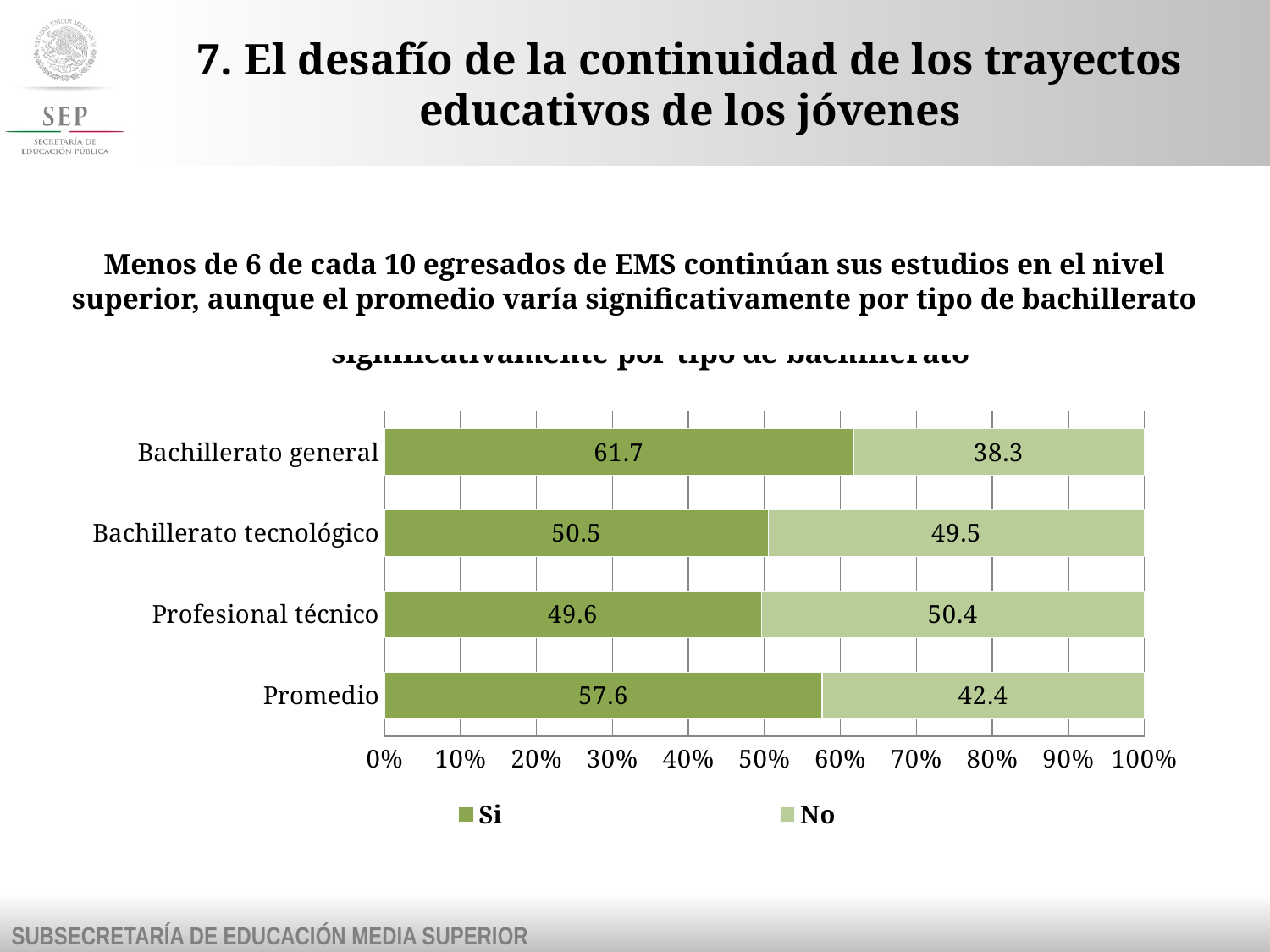
Which category has the highest "Si" value? Bachillerato general How many categories are shown on the chart? 4 Which category has the lowest "Si" value? Profesional técnico What is the "No" value for Profesional técnico? 50.4 What is the "No" value for Bachillerato tecnológico? 49.5 What is the "Si" value for Bachillerato general? 61.7 Which is larger: the "No" value for Bachillerato general or the "No" value for Promedio? Promedio What is the "Si" value for Promedio? 57.6 What is the difference between the "Si" values for Bachillerato general and Bachillerato tecnológico? 11.2 How many series does the legend list? 2 What are the two series listed in the legend? Si and No What kind of chart is shown on the slide? Stacked bar chart